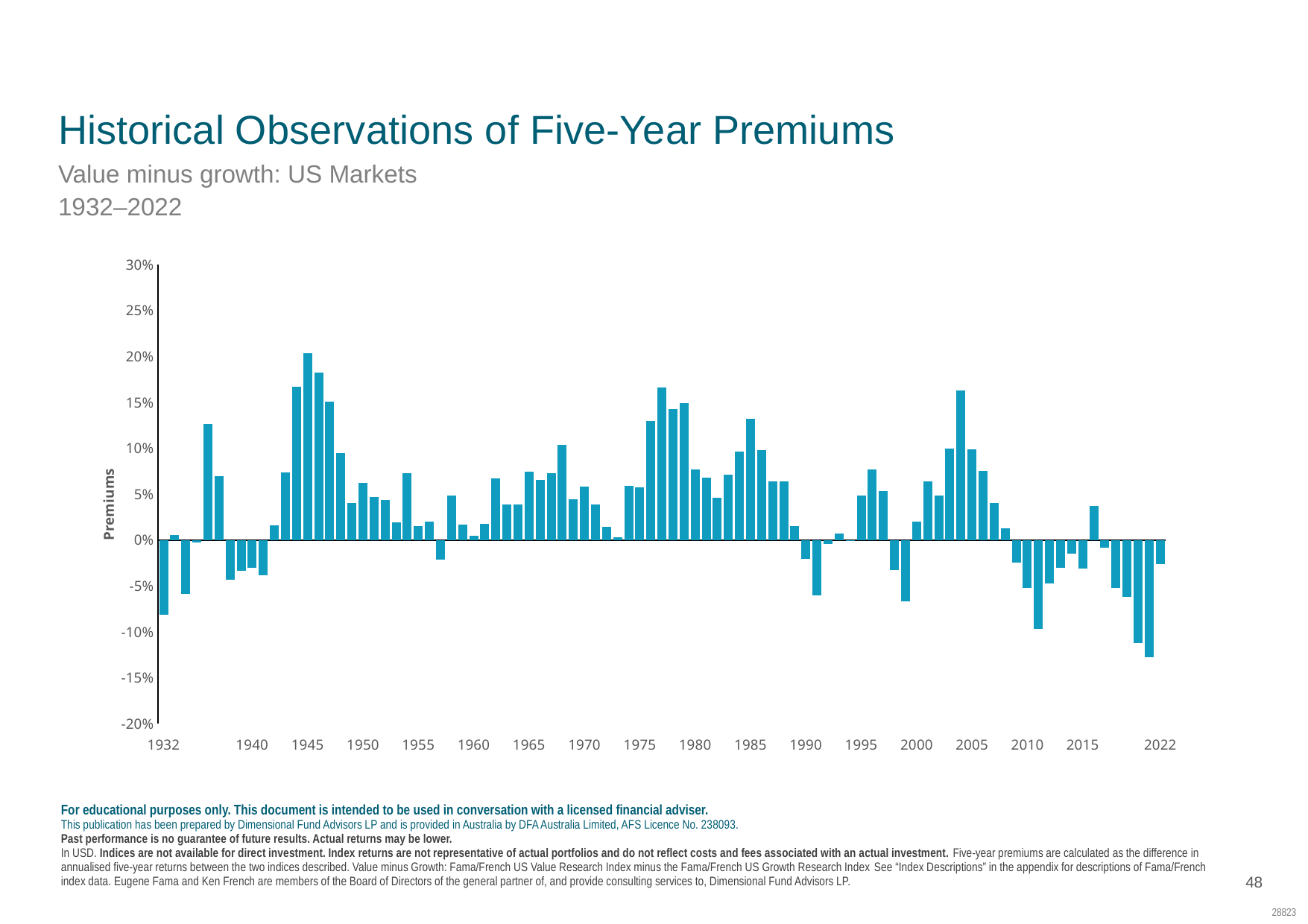
Is the value for 2022 greater or less than 0%? less What kind of chart is shown on the slide? Bar chart Which is larger, the value for 1945 or the value for 1985? 1945 Is the value for 1932 greater or less than -5%? less Is the value for 2000 greater or less than -5%? greater What is the label on the vertical axis of the chart? Premiums Which year has the highest five-year premium on the chart? 1945 Between 1945 and 1949, do the values generally rise or fall? fall Which is larger, the value for 1932 or the value for 2022? 2022